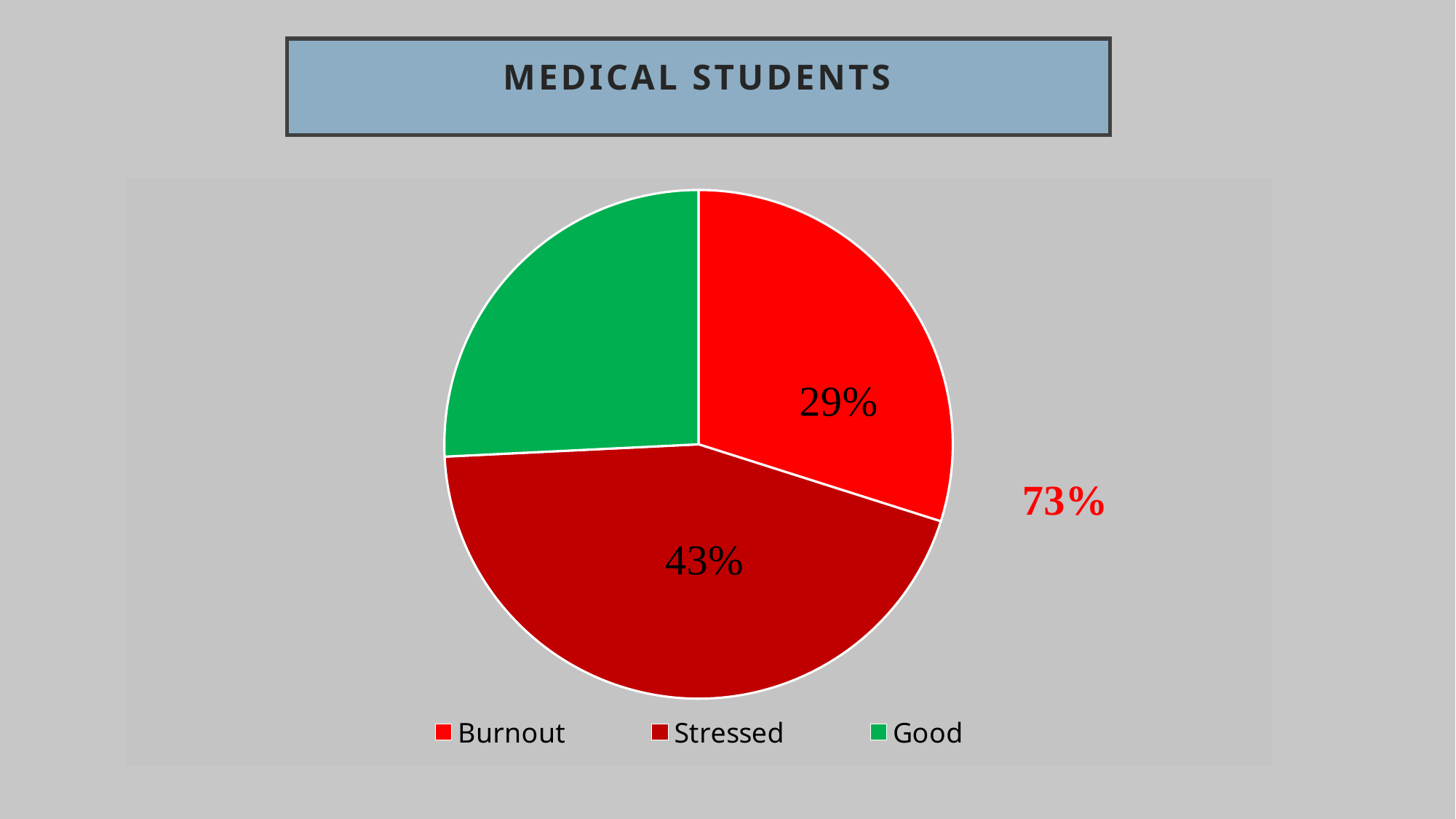
What is the title shown above the chart? MEDICAL STUDENTS What percentage of the pie is labelled for the Stressed slice? 43% What percentage of the pie is labelled for the Burnout slice? 29% Which is larger, the Stressed slice or the Burnout slice? Stressed Which category has the largest slice of the pie? Stressed How many categories does the legend list? 3 What colour is the Good slice of the pie? green What is the difference in percentage points between the Stressed slice and the Burnout slice? 14 What kind of chart is shown on the slide? pie chart Which is larger, the Stressed slice or the Good slice? Stressed What share of the pie does the Burnout slice represent? 29%